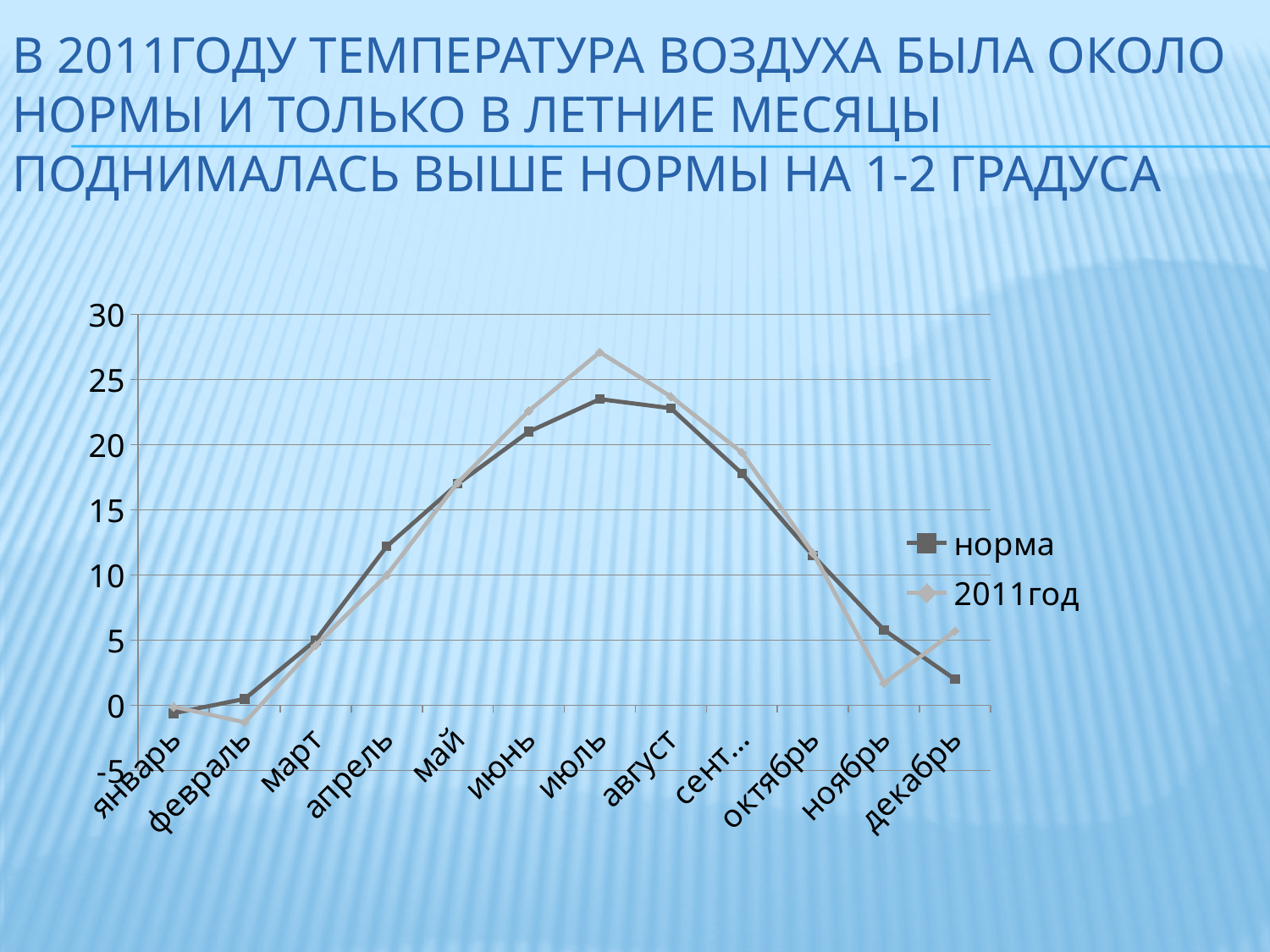
Is the value of the 2011год series in ноябрь greater or less than 5? less Is the value of the норма series in апрель greater or less than 10? greater How many series does the chart legend list? 2 In which month is the 2011год series at its lowest value? февраль In июль, which series has the larger value, норма or 2011год? 2011год In which month does the 2011год series reach its highest value? июль In ноябрь, which series has the larger value, норма or 2011год? норма What kind of chart is shown on the slide? line chart How many months (categories) are plotted along the x axis? 12 In which month does the норма series reach its highest value? июль Is the value of the 2011год series in июль greater or less than 25? greater Does the норма series rise or fall from январь to июль? rise